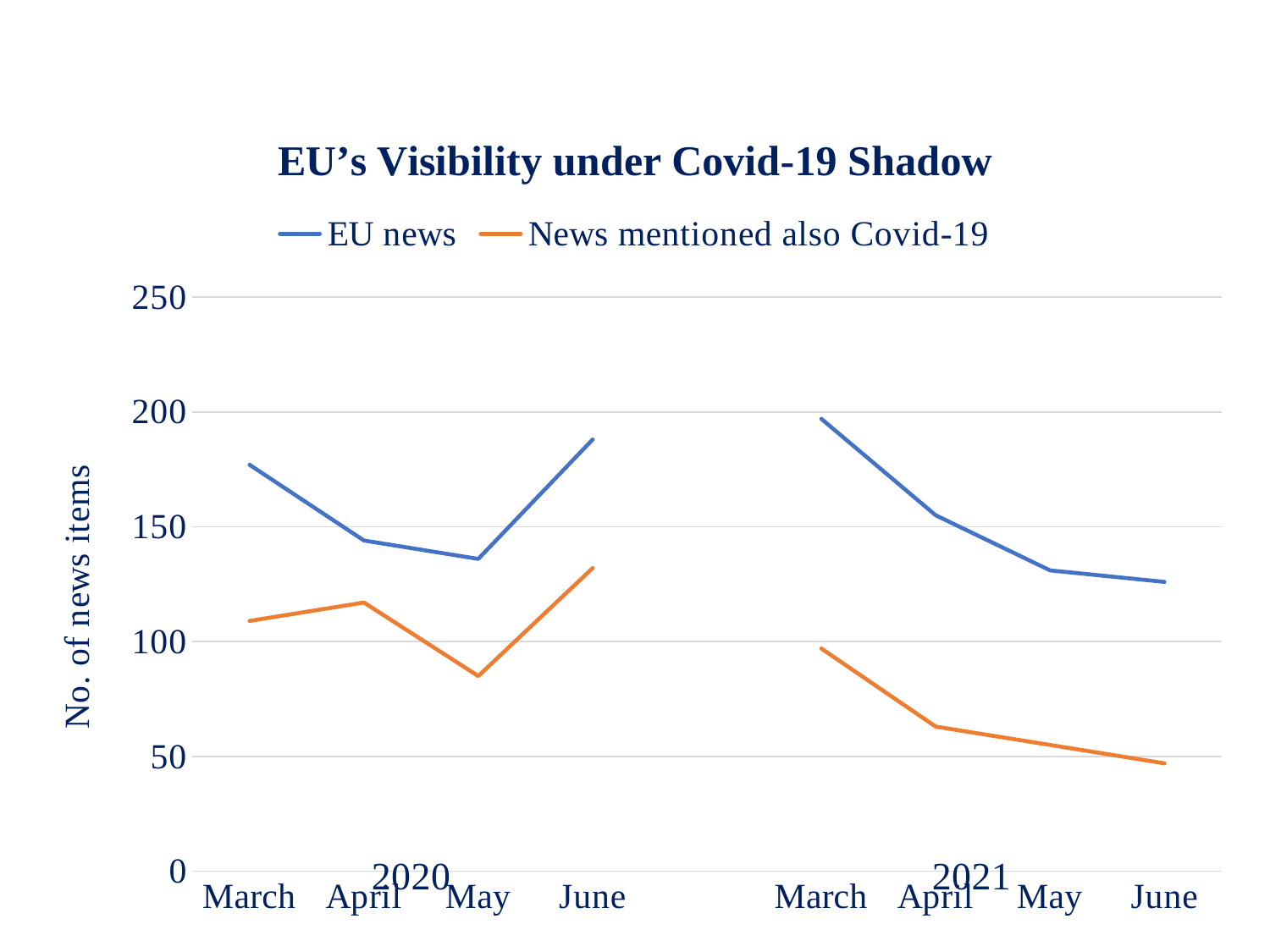
Is the value for EU news in June 2021 greater or less than 150? less What is the title of the chart? EU's Visibility under Covid-19 Shadow How many series does the legend list? 2 How many months are plotted along the x axis in total? 8 Do the values for EU news rise or fall from March 2021 to June 2021? fall Which is larger in June 2020: EU news or News mentioned also Covid-19? EU news Is the value for News mentioned also Covid-19 in April 2021 greater or less than 100? less Is the value for EU news in March 2020 greater or less than 150? greater What kind of chart is shown on the slide? line chart In which month is the value for News mentioned also Covid-19 lowest? June 2021 What is the label on the vertical axis? No. of news items